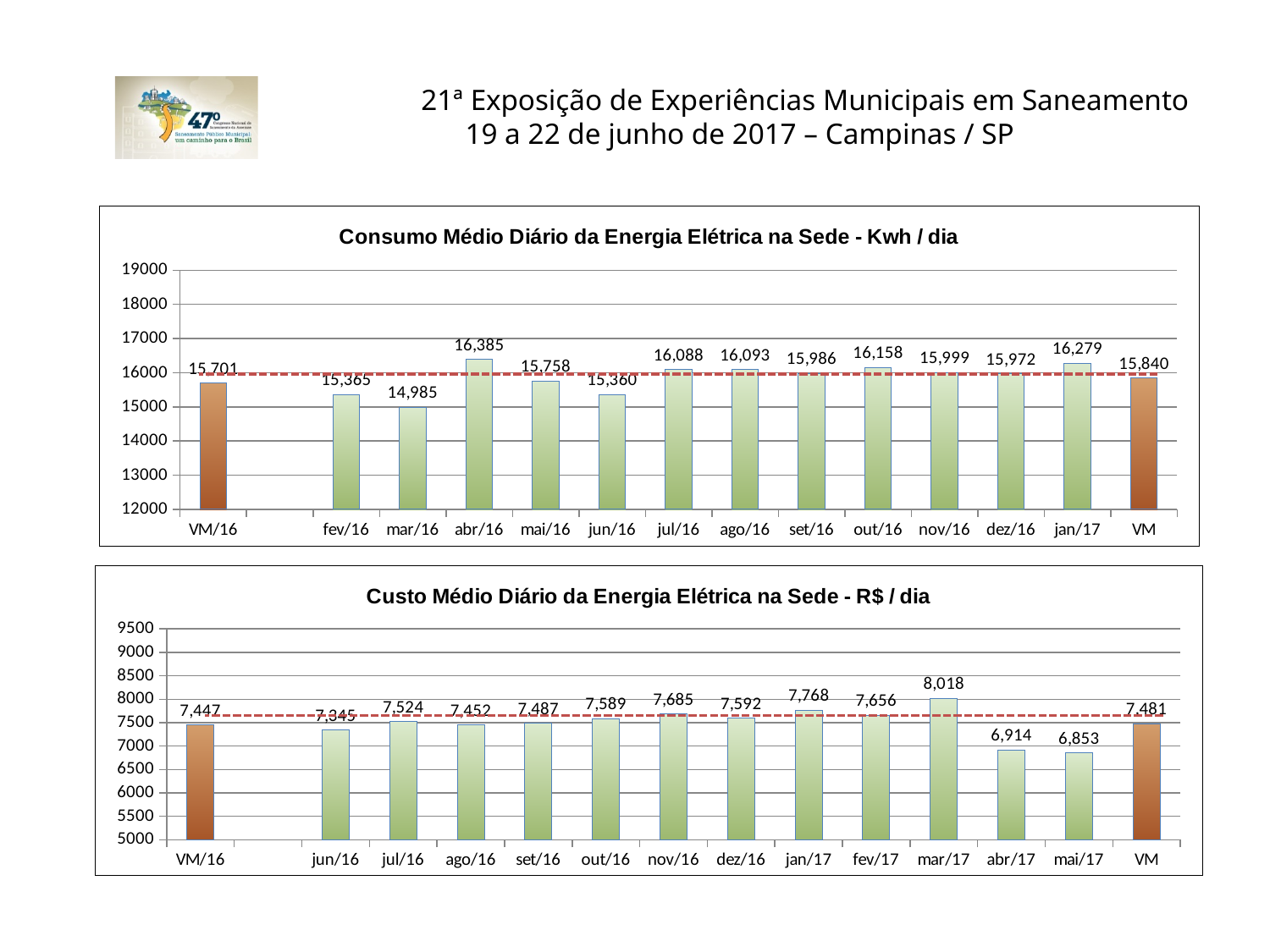
In the top chart (Consumo Médio Diário da Energia Elétrica na Sede), which month has the highest consumption? abr/16 In the top chart (Consumo Médio Diário da Energia Elétrica na Sede), what is the value for abr/16? 16,385 In the bottom chart (Custo Médio Diário da Energia Elétrica na Sede), which month has the highest cost? mar/17 In the bottom chart (Custo Médio Diário da Energia Elétrica na Sede), which month has the lowest cost? mai/17 In the top chart (Consumo Médio Diário da Energia Elétrica na Sede), how many bars are plotted? 14 In the top chart (Consumo Médio Diário da Energia Elétrica na Sede), what is the difference between jan/17 and dez/16? 307 In the bottom chart (Custo Médio Diário da Energia Elétrica na Sede), what is the difference between mar/17 and abr/17? 1,104 In the bottom chart (Custo Médio Diário da Energia Elétrica na Sede), which is larger, jan/17 or fev/17? jan/17 In the bottom chart (Custo Médio Diário da Energia Elétrica na Sede), what is the value for VM? 7,481 In the bottom chart (Custo Médio Diário da Energia Elétrica na Sede), what is the value for mar/17? 8,018 In the top chart (Consumo Médio Diário da Energia Elétrica na Sede), which month has the lowest consumption? mar/16 What kind of chart is the top chart on the slide? Bar chart